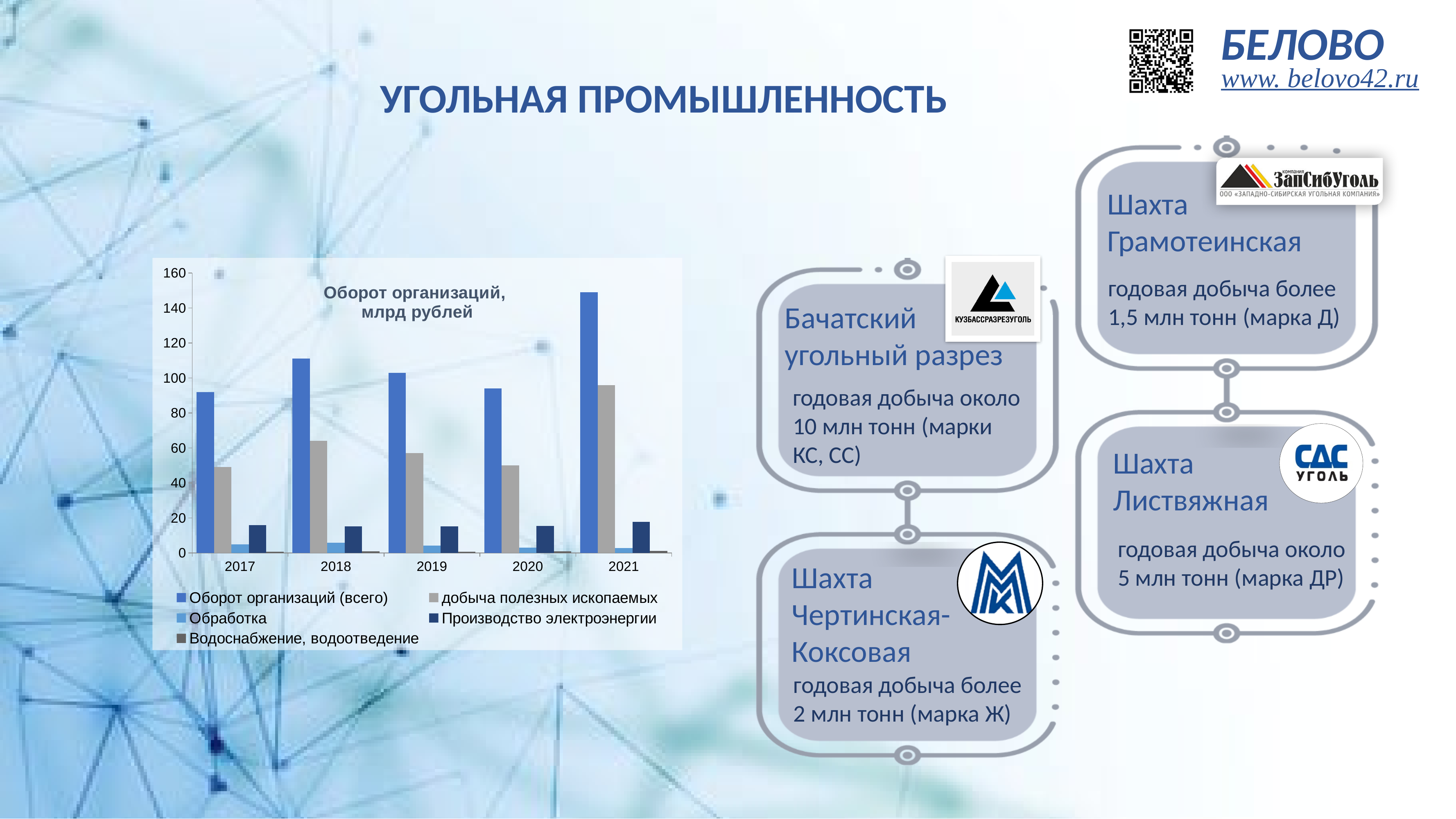
How many series does the chart legend list? 5 Which series has the larger value in 2020, добыча полезных ископаемых or Производство электроэнергии? добыча полезных ископаемых In which year is the value for Оборот организаций (всего) the highest? 2021 In which year is the value for Оборот организаций (всего) the lowest? 2017 What kind of chart is shown on the slide? bar chart What is the title of the chart? Оборот организаций, млрд рублей Is the value for добыча полезных ископаемых in 2021 greater or less than 80? greater Is the value for Оборот организаций (всего) in 2021 greater or less than 140? greater Is the value for Оборот организаций (всего) in 2018 greater or less than 100? greater Which year has the larger value for Оборот организаций (всего), 2018 or 2019? 2018 In which year is the value for добыча полезных ископаемых the highest? 2021 How many years are shown on the x axis of the chart? 5